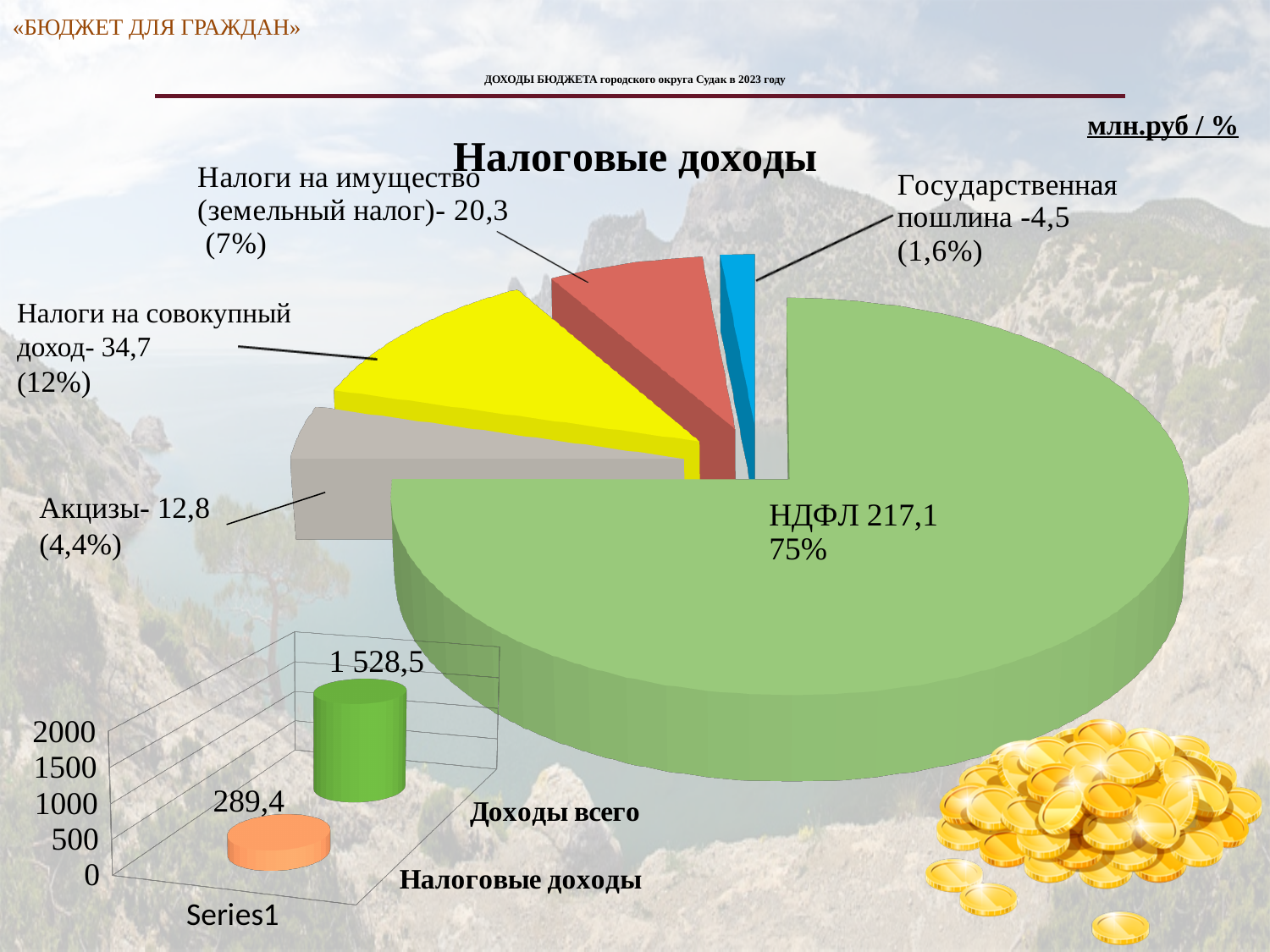
In the pie chart 'Налоговые доходы', how many slices are there? 5 In the pie chart 'Налоговые доходы', what share of the pie does Государственная пошлина take? 1,6% In the bar chart at the bottom left, what is the value for Налоговые доходы? 289,4 In the pie chart 'Налоговые доходы', what share of the pie does НДФЛ take? 75% In the pie chart 'Налоговые доходы', what is the value for НДФЛ? 217,1 In the bar chart at the bottom left, what is the value for Доходы всего? 1 528,5 In the pie chart 'Налоговые доходы', what is the difference between Налоги на совокупный доход and Налоги на имущество (земельный налог)? 14,4 In the bar chart at the bottom left, what is the difference between Доходы всего and Налоговые доходы? 1 239,1 In the pie chart 'Налоговые доходы', which category has the largest value? НДФЛ In the pie chart 'Налоговые доходы', which is larger: Налоги на совокупный доход or Акцизы? Налоги на совокупный доход In the pie chart 'Налоговые доходы', what is the value for Акцизы? 12,8 In the pie chart 'Налоговые доходы', which category has the smallest value? Государственная пошлина